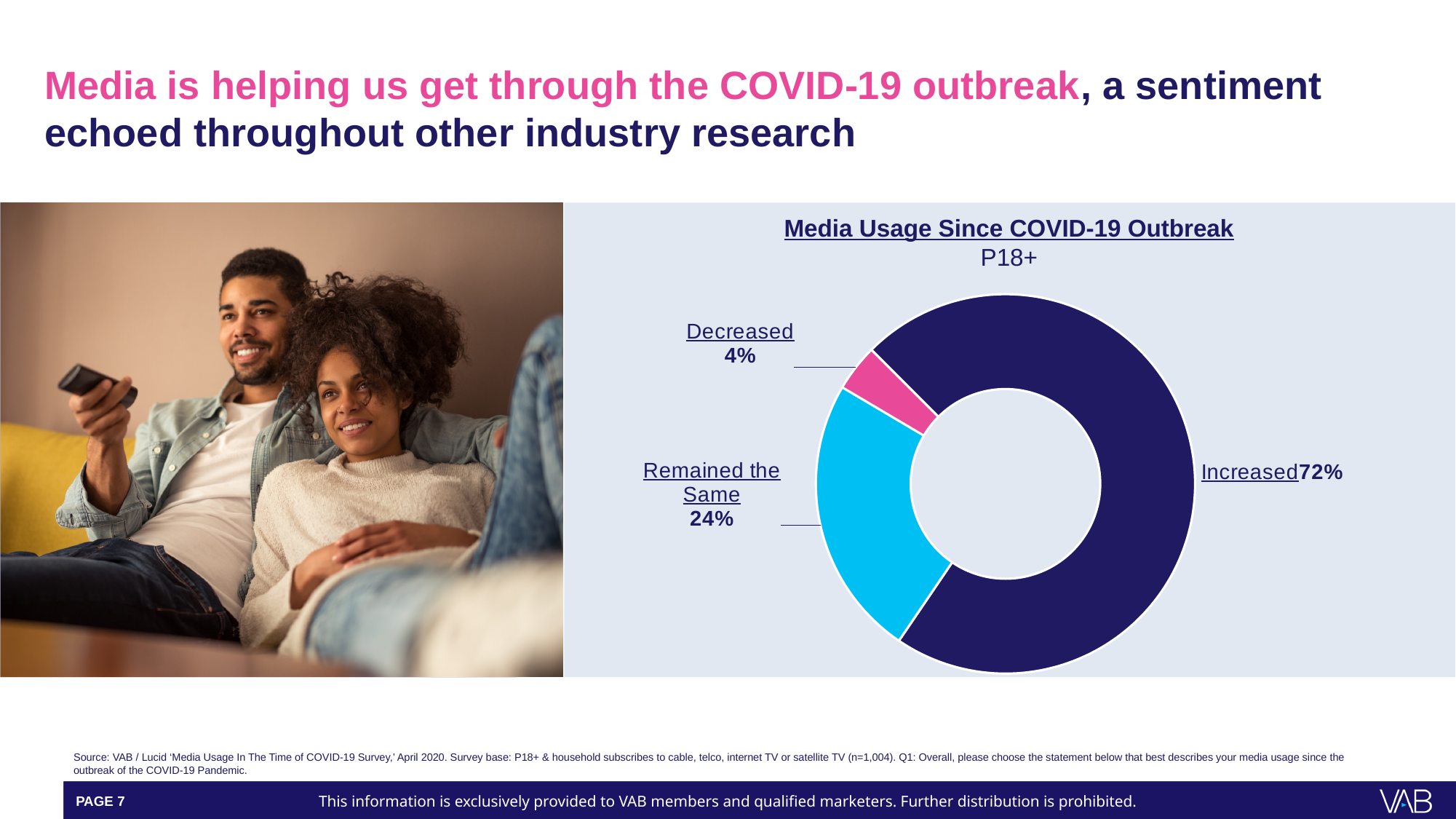
Which is larger, the share for Remained the Same or the share for Decreased? Remained the Same How many categories are shown in the chart? 3 What percentage of respondents said their media usage decreased? 4% What colour is the Decreased slice of the chart? Pink Which category has the smallest share of the chart? Decreased What kind of chart is shown on the slide? Doughnut (pie) chart What is the difference in percentage points between Remained the Same and Decreased? 20 What percentage of respondents said their media usage increased since the COVID-19 outbreak? 72% What is the difference in percentage points between Increased and Remained the Same? 48 Which category has the largest share of the chart? Increased What is the title of the chart? Media Usage Since COVID-19 Outbreak What percentage of respondents said their media usage remained the same? 24%